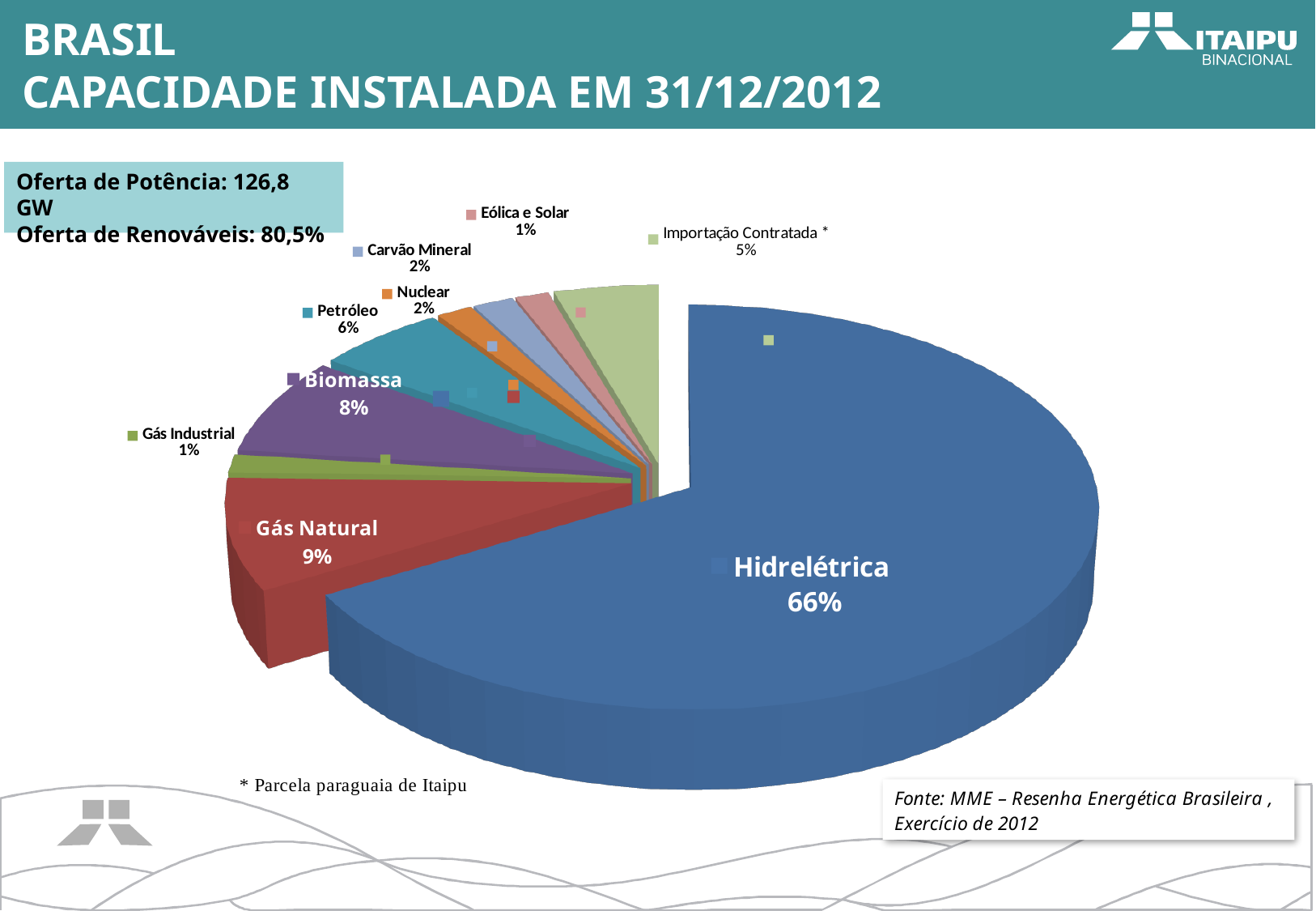
What percentage is shown for Biomassa? 8% What is the title of the slide containing the chart? BRASIL CAPACIDADE INSTALADA EM 31/12/2012 What is the difference in percentage points between Petróleo and Nuclear? 4 What percentage is shown for Importação Contratada? 5% Which category has the largest slice of the pie? Hidrelétrica Which is larger, the share for Gás Natural or the share for Biomassa? Gás Natural What is the difference in percentage points between Hidrelétrica and Gás Natural? 57 How many categories are shown in the pie chart? 9 What share of the pie does Hidrelétrica represent? 66% What percentage is shown for Petróleo? 6% What kind of chart is shown on the slide? Pie chart What percentage is shown for Gás Natural? 9%